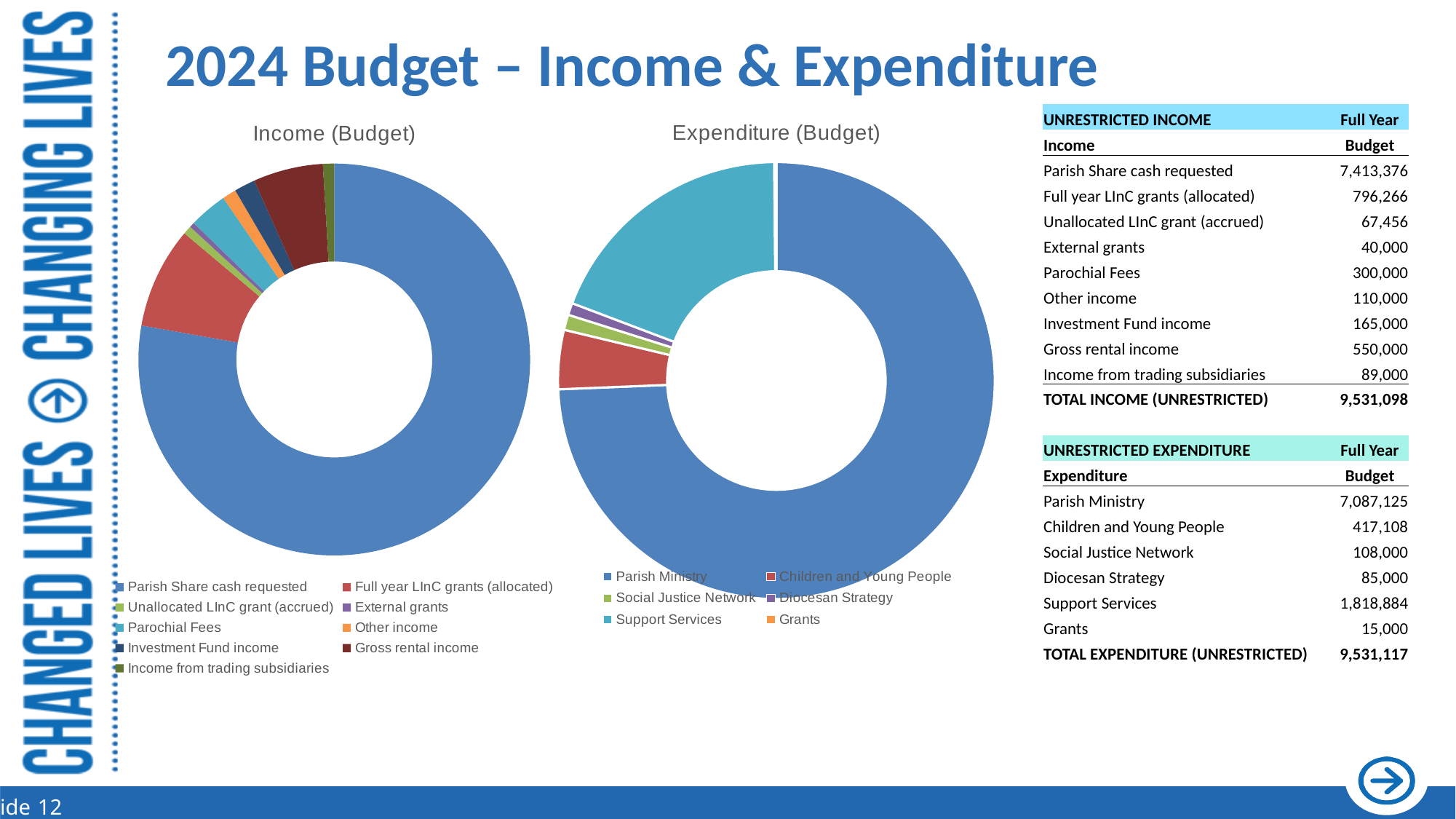
What kind of chart is the Income (Budget) chart? Doughnut (pie) chart According to the table, which expenditure category has the smallest value? Grants In the Expenditure (Budget) chart, which category has the second-largest slice? Support Services In the Expenditure (Budget) chart, which category has the largest slice? Parish Ministry In the Income (Budget) chart, which is larger: the Full year LInC grants (allocated) slice or the Parochial Fees slice? Full year LInC grants (allocated) According to the table, what is the budget value for Parish Share cash requested shown in the Income (Budget) chart? 7,413,376 How many categories does the Income (Budget) chart's legend list? 9 In the Income (Budget) chart, which category has the largest slice? Parish Share cash requested In the Expenditure (Budget) chart, which is larger: the Children and Young People slice or the Social Justice Network slice? Children and Young People Using the table values, what is the difference between Parish Ministry and Support Services expenditure? 5,268,241 According to the table, what is the budget value for Parish Ministry shown in the Expenditure (Budget) chart? 7,087,125 How many categories does the Expenditure (Budget) chart's legend list? 6